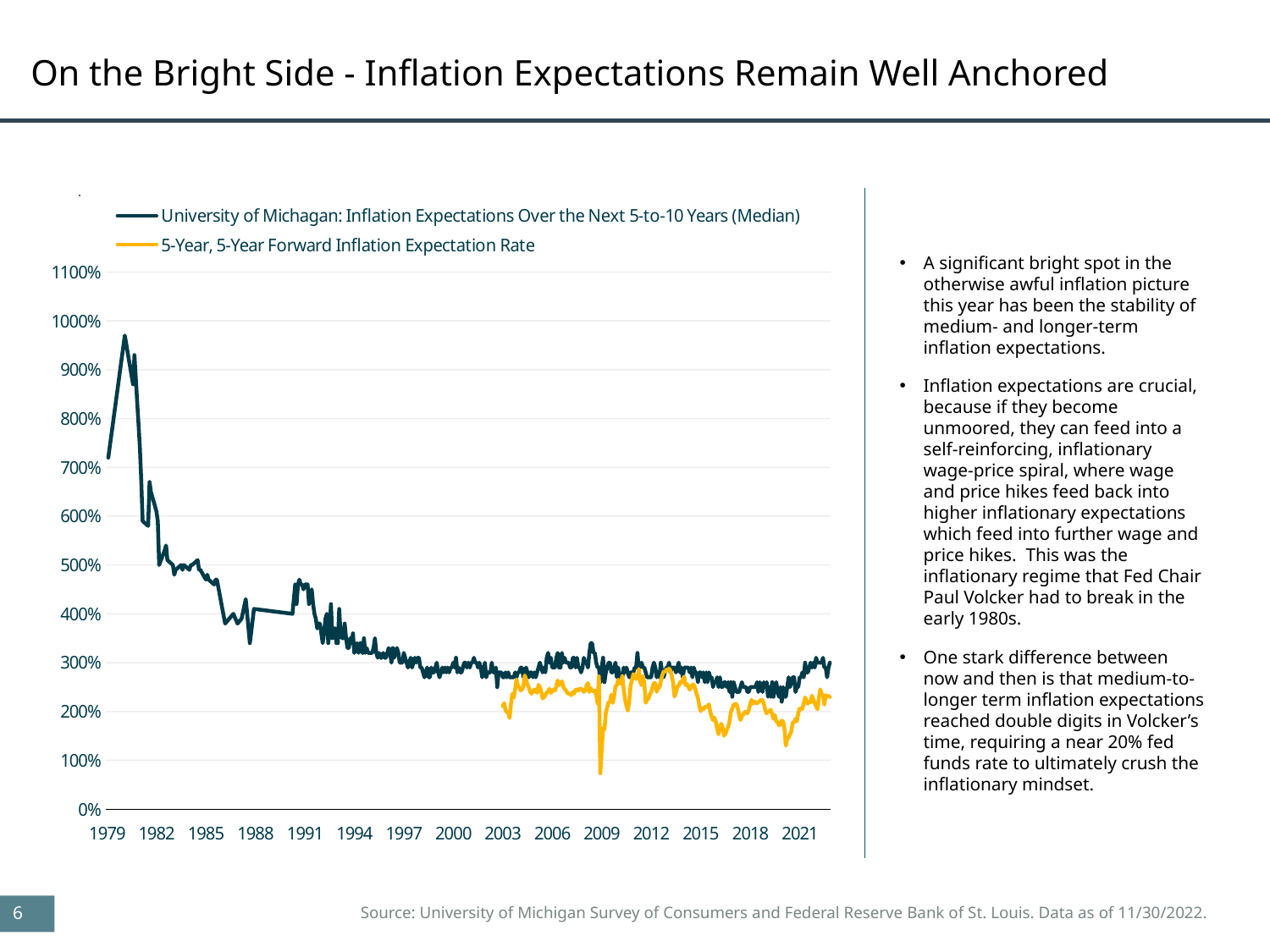
Over the full period from 1979 to 2021, does the University of Michigan series generally rise or fall? fall Is the value of the University of Michigan series at 1991 greater or less than 400%? greater Is the value of the University of Michigan series at 2003 greater or less than 300%? less What is the name of the series drawn in dark blue? University of Michagan: Inflation Expectations Over the Next 5-to-10 Years (Median) How many year labels are shown on the x axis? 15 What kind of chart is shown on the slide? Line chart Is the peak value of the University of Michigan series greater or less than 900%? greater How many series does the chart's legend list? 2 Which is larger for the University of Michigan series: the value at 1982 or the value at 2021? 1982 What is the name of the series drawn in yellow? 5-Year, 5-Year Forward Inflation Expectation Rate Which series begins earlier on the x axis? University of Michagan: Inflation Expectations Over the Next 5-to-10 Years (Median)